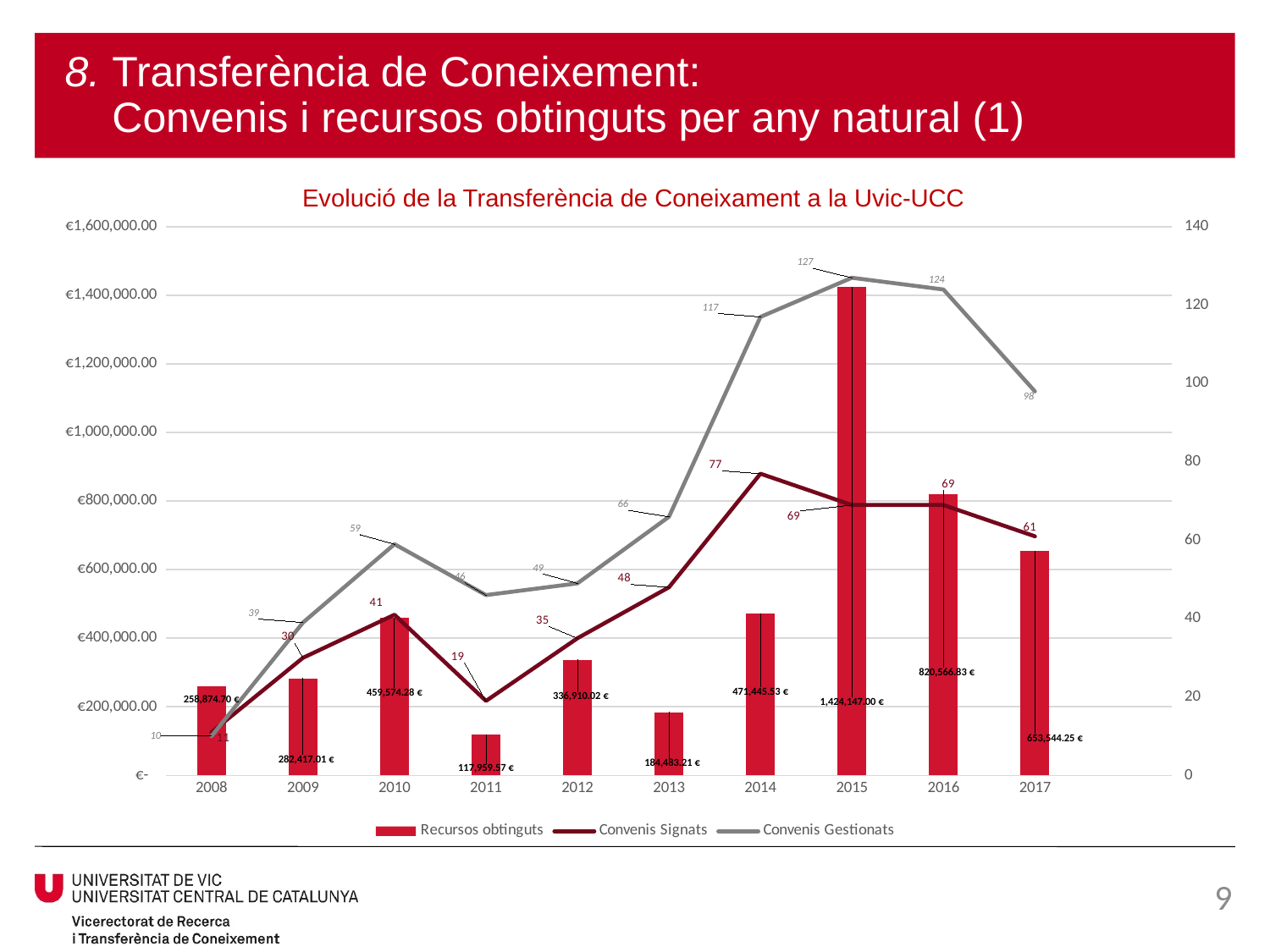
How many series does the legend list? 3 Which year has the highest number of Convenis Gestionats? 2015 How many Convenis Gestionats were there in 2014? 117 How many years are shown on the x axis? 10 Which is larger, the Recursos obtinguts for 2016 or for 2017? 2016 What is the difference in Convenis Signats between 2014 and 2013? 29 What is the value of Recursos obtinguts for 2015? 1,424,147.00 € How many Convenis Signats were there in 2017? 61 Which year has the highest value of Recursos obtinguts? 2015 Which year has the lowest value of Recursos obtinguts? 2011 Do the Convenis Gestionats rise or fall from 2016 to 2017? fall Is the value of Recursos obtinguts for 2014 greater or less than €400,000.00? greater